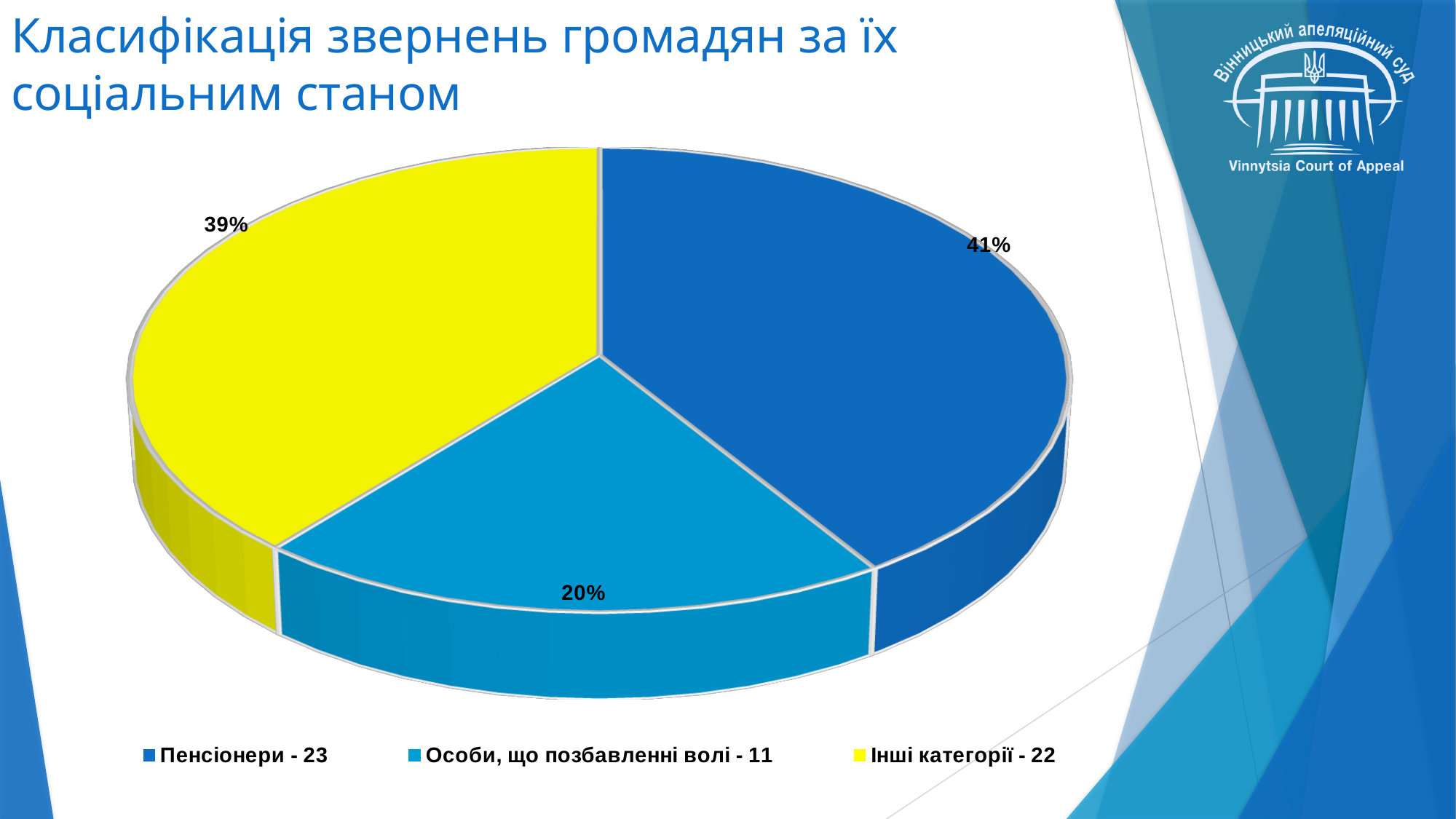
What percentage share does the "Інші категорії - 22" slice have? 39% Which category has the smallest share of the pie? Особи, що позбавленні волі - 11 What is the title of the slide containing the pie chart? Класифікація звернень громадян за їх соціальним станом What percentage share does the "Особи, що позбавленні волі - 11" slice have? 20% What is the difference in percentage points between the "Пенсіонери - 23" slice and the "Особи, що позбавленні волі - 11" slice? 21% What is the difference in percentage points between the "Пенсіонери - 23" slice and the "Інші категорії - 22" slice? 2% What percentage share does the "Пенсіонери - 23" slice have? 41% What colour is the "Інші категорії - 22" slice? yellow What kind of chart is shown on the slide? pie chart Which slice is larger: "Інші категорії - 22" or "Особи, що позбавленні волі - 11"? Інші категорії - 22 Which category has the largest share of the pie? Пенсіонери - 23 How many slices does the pie chart have? 3